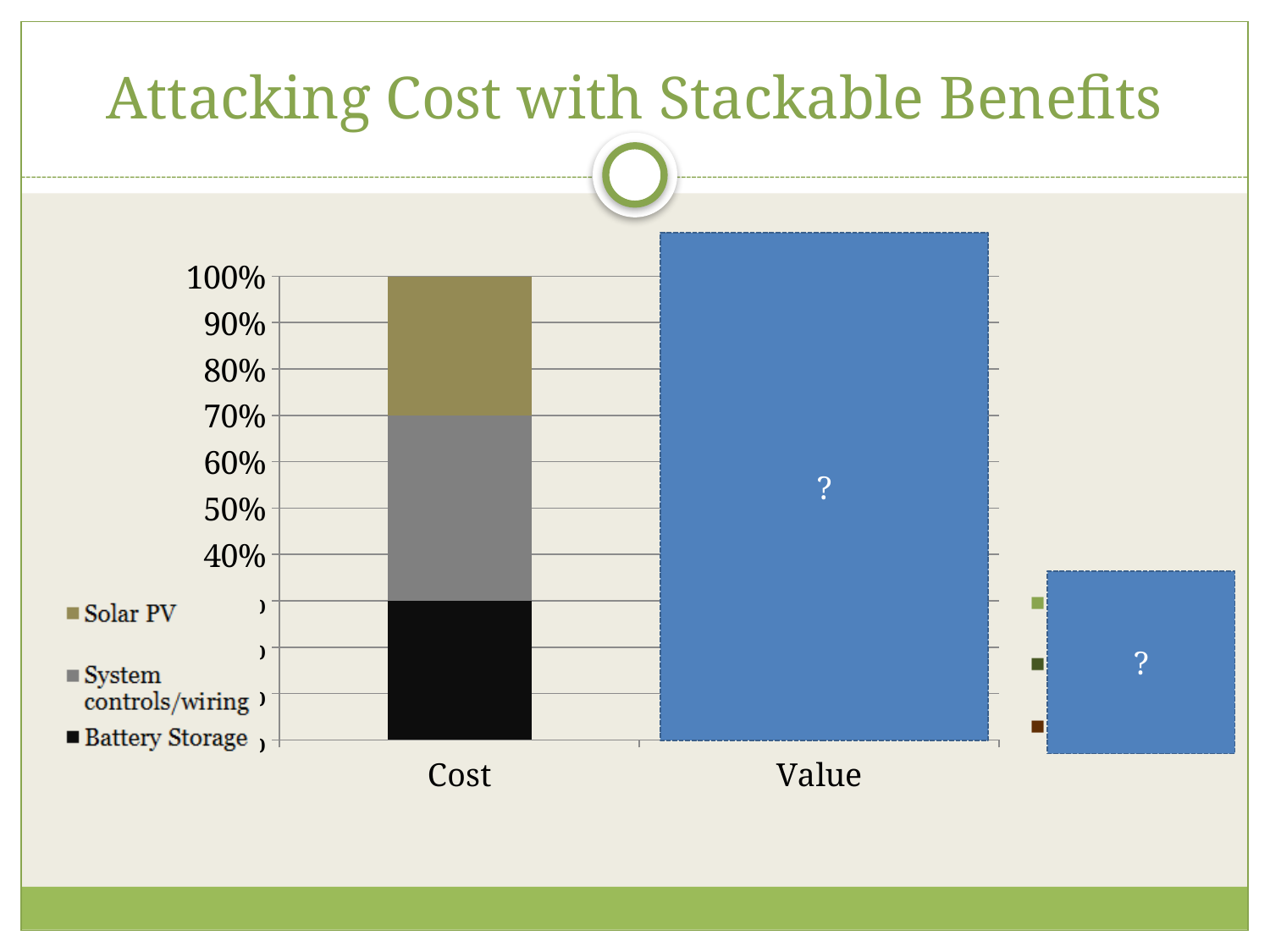
What are the two categories on the x axis? Cost and Value At what percentage does the Solar PV segment of the Cost bar begin? 70% What kind of chart is shown on the slide? bar chart Which segment of the Cost bar is the largest? System controls/wiring Which segment is at the bottom of the Cost bar? Battery Storage Is the top of the System controls/wiring segment in the Cost bar greater or less than 60%? greater How many categories are shown on the x axis? 2 What is the total height of the stacked Cost bar? 100% Is the top of the Battery Storage segment in the Cost bar greater or less than 40%? less What is the title of the slide containing the chart? Attacking Cost with Stackable Benefits